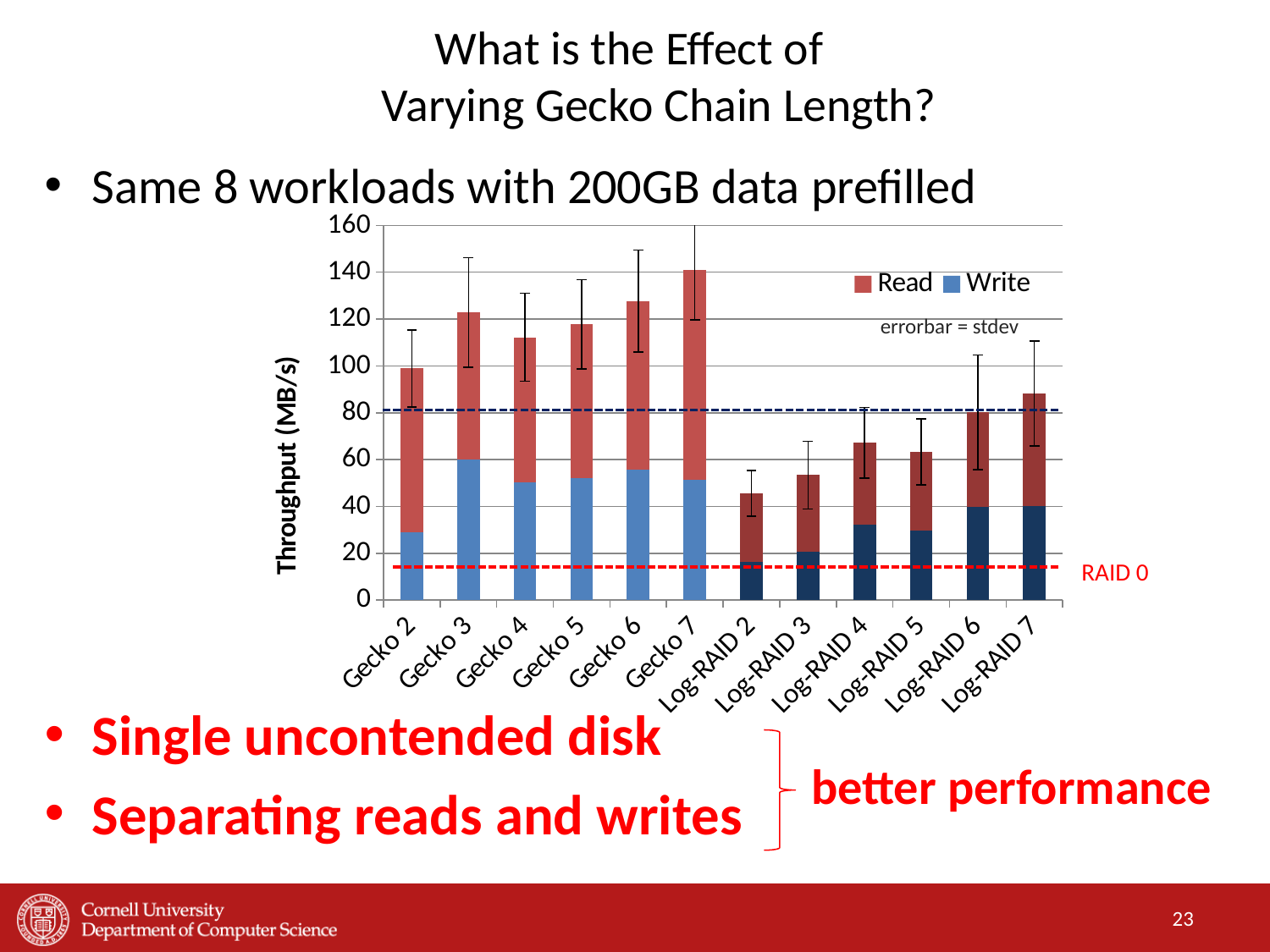
Is the total throughput for Gecko 7 greater or less than 120? greater How many categories are shown on the x axis of the chart? 12 Which category has the lowest total throughput? Log-RAID 2 Which has the larger total throughput, Gecko 6 or Gecko 7? Gecko 7 Is the total throughput for Gecko 4 greater or less than 100? greater Which category has the highest total throughput? Gecko 7 How many series does the chart legend list? 2 Is the total throughput for Log-RAID 2 greater or less than 60? less What is the label of the y axis of the chart? Throughput (MB/s) Which has the larger total throughput, Gecko 2 or Log-RAID 7? Gecko 2 What kind of chart is shown on the slide? Stacked bar chart